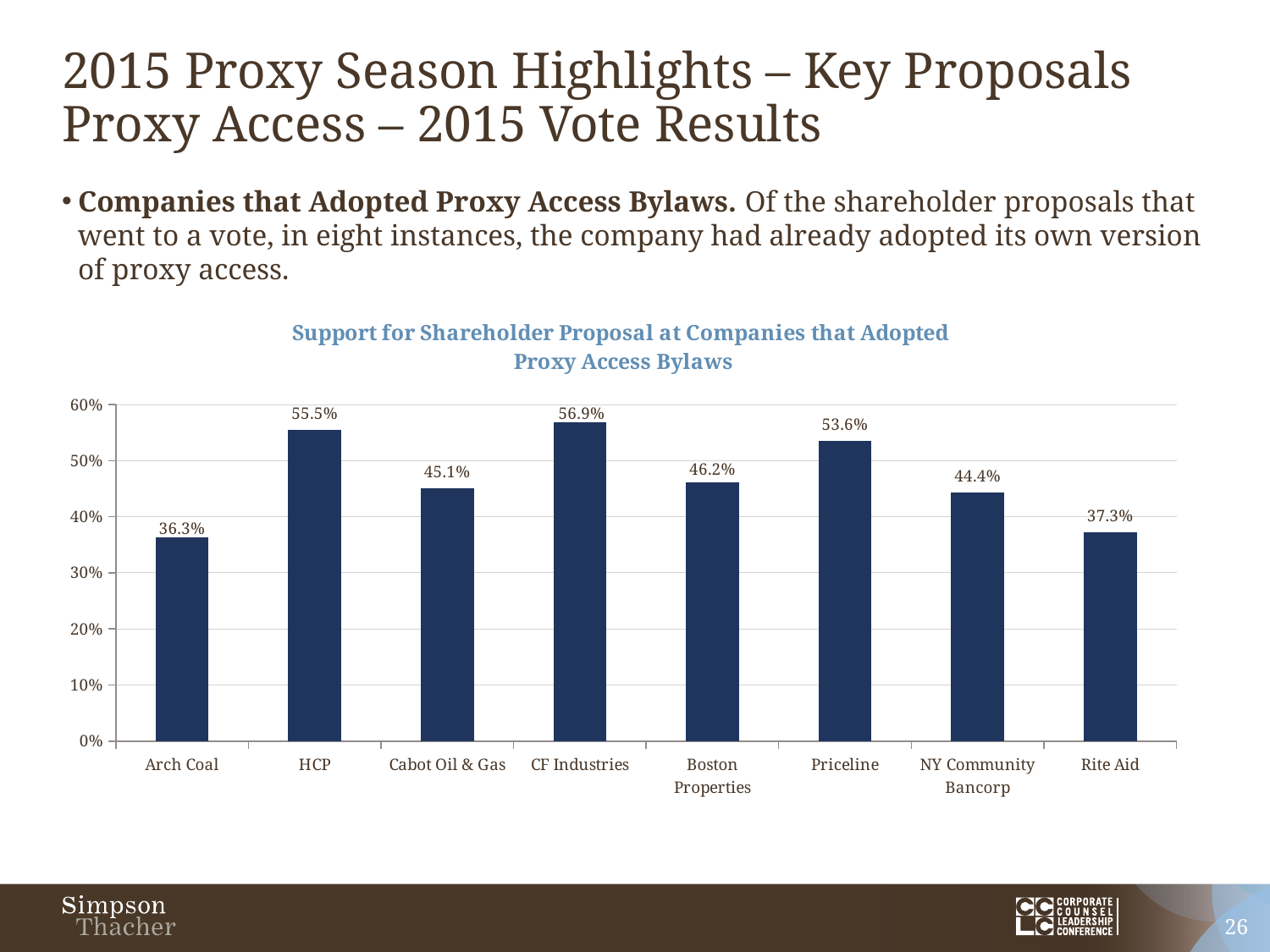
What is the support percentage for HCP? 55.5% What kind of chart is shown on the slide? Bar chart Is the value for NY Community Bancorp greater or less than 50%? less Which company has the highest support for the shareholder proposal? CF Industries What is the support percentage for Boston Properties? 46.2% Which company has the lowest support for the shareholder proposal? Arch Coal What is the difference in support between Priceline and NY Community Bancorp? 9.2% How many companies are shown in the chart? 8 What is the difference in support between CF Industries and Arch Coal? 20.6% What is the title of the chart? Support for Shareholder Proposal at Companies that Adopted Proxy Access Bylaws Which has higher support, Cabot Oil & Gas or Priceline? Priceline What is the support percentage for Rite Aid? 37.3%